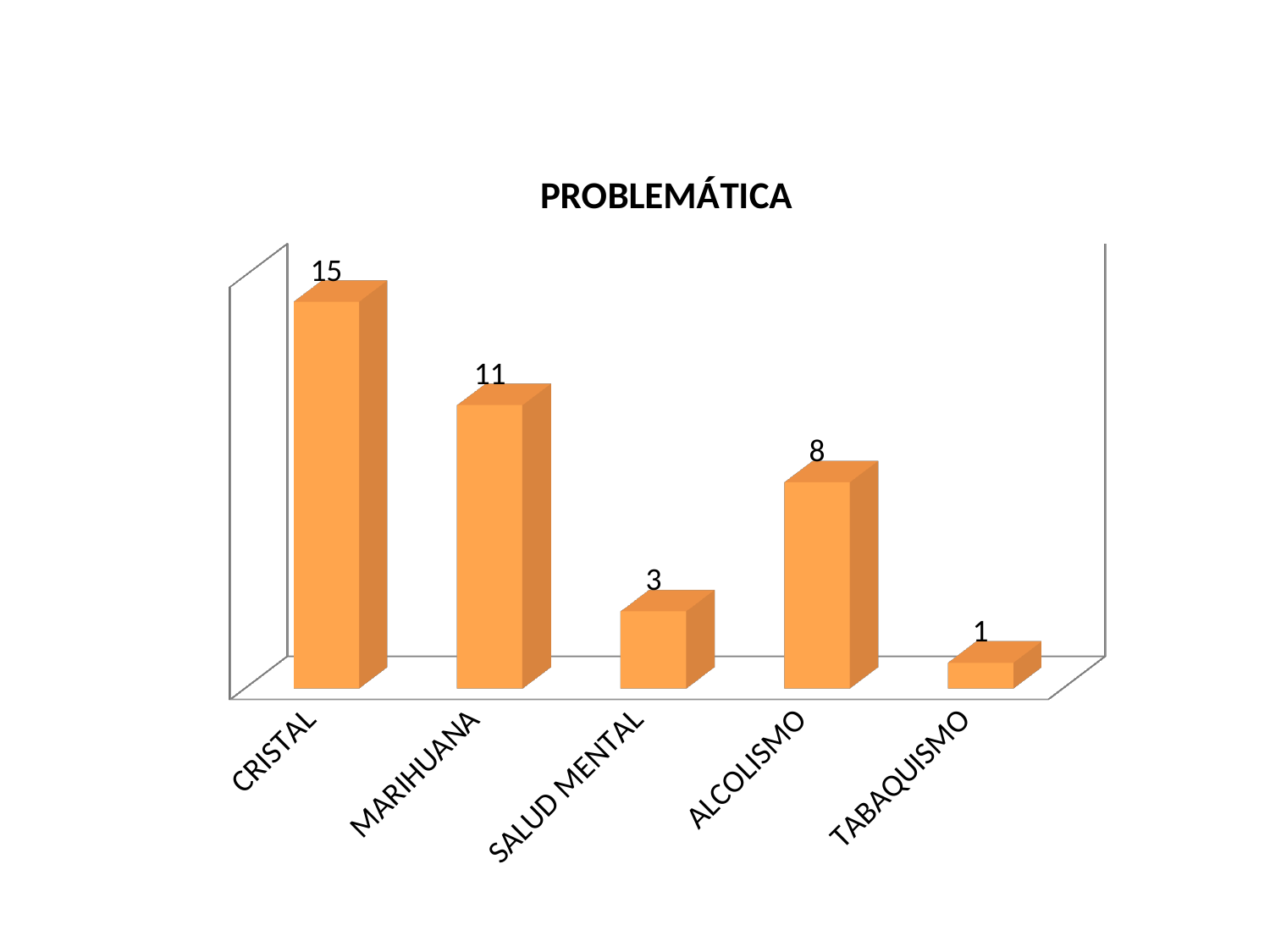
What kind of chart is shown on the slide? Bar chart What is the value for ALCOLISMO? 8 How many categories are shown in the chart? 5 What is the difference between the values for CRISTAL and MARIHUANA? 4 What is the value for MARIHUANA? 11 What is the value for TABAQUISMO? 1 What is the value for CRISTAL? 15 What is the value for SALUD MENTAL? 3 Which is larger, the value for ALCOLISMO or the value for SALUD MENTAL? ALCOLISMO Which category has the highest value? CRISTAL Which category has the lowest value? TABAQUISMO What is the title of the chart? PROBLEMÁTICA